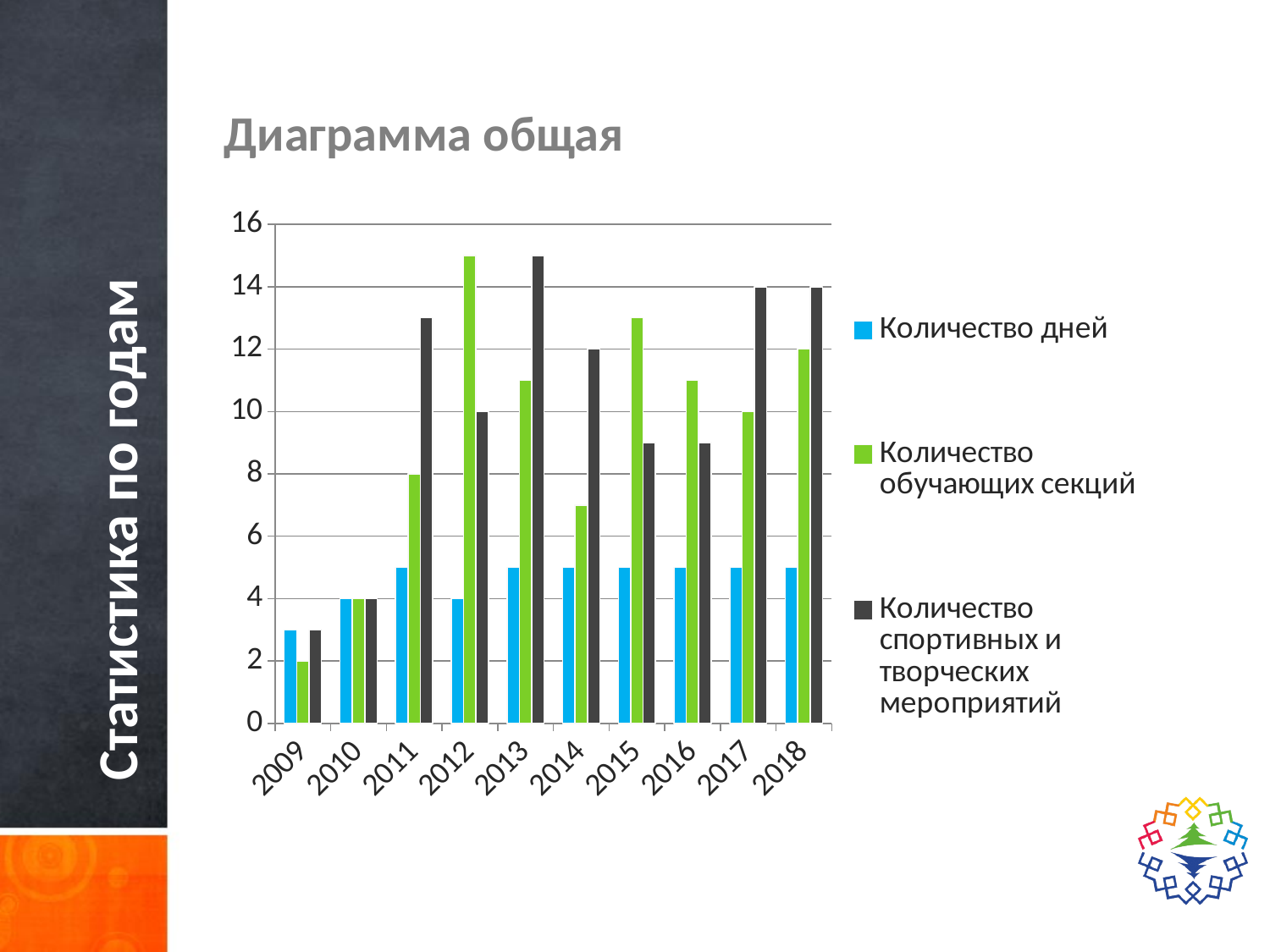
Is the value of Количество дней for 2015 greater or less than 6? less How many series does the legend list? 3 Which year has the lowest value for Количество спортивных и творческих мероприятий? 2009 What is the value of Количество спортивных и творческих мероприятий for 2014? 12 What is the value of Количество спортивных и творческих мероприятий for 2017? 14 What is the value of Количество обучающих секций for 2011? 8 What is the value of Количество обучающих секций for 2018? 12 Is the value of Количество обучающих секций for 2012 greater or less than 14? greater Which year has the highest value for Количество обучающих секций? 2012 What kind of chart is shown on the slide? bar chart For 2013, which is larger: Количество обучающих секций or Количество спортивных и творческих мероприятий? Количество спортивных и творческих мероприятий How many years are shown on the x axis? 10